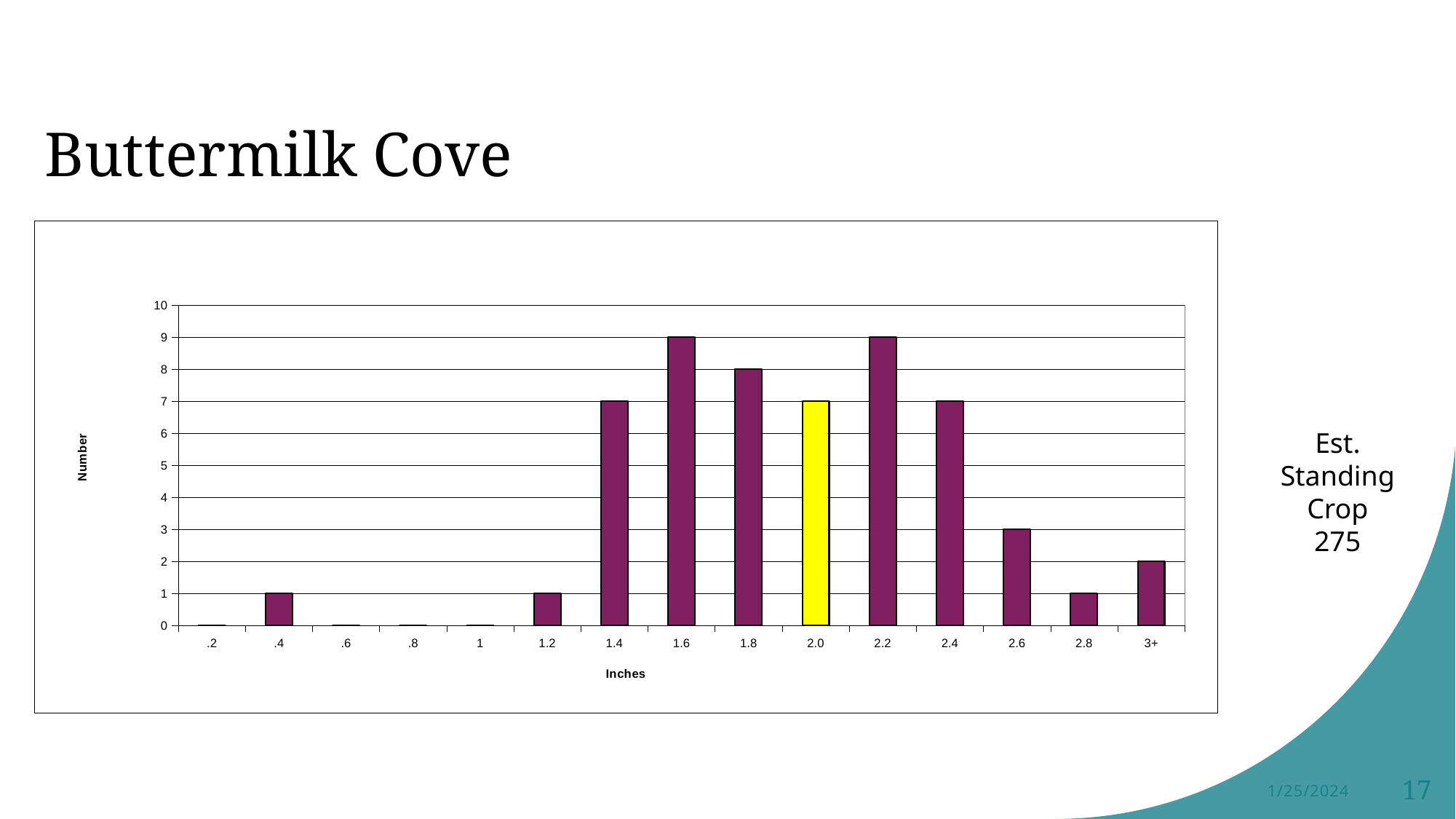
What is the value for 1.6 inches? 9 What is the value for 2.0 inches, the yellow bar? 7 Which is larger, the value for 1.8 inches or the value for 2.8 inches? 1.8 inches Which category's bar is coloured yellow instead of purple? 2.0 What is the value for 2.6 inches? 3 What is the value for 1.8 inches? 8 What is the value for the 3+ inches category? 2 Is the value for 1.4 inches greater or less than 5? greater How many categories are shown on the x axis? 15 What kind of chart is shown on the slide? bar chart What is the label on the y axis of the chart? Number What is the difference between the values for 1.6 inches and 2.6 inches? 6